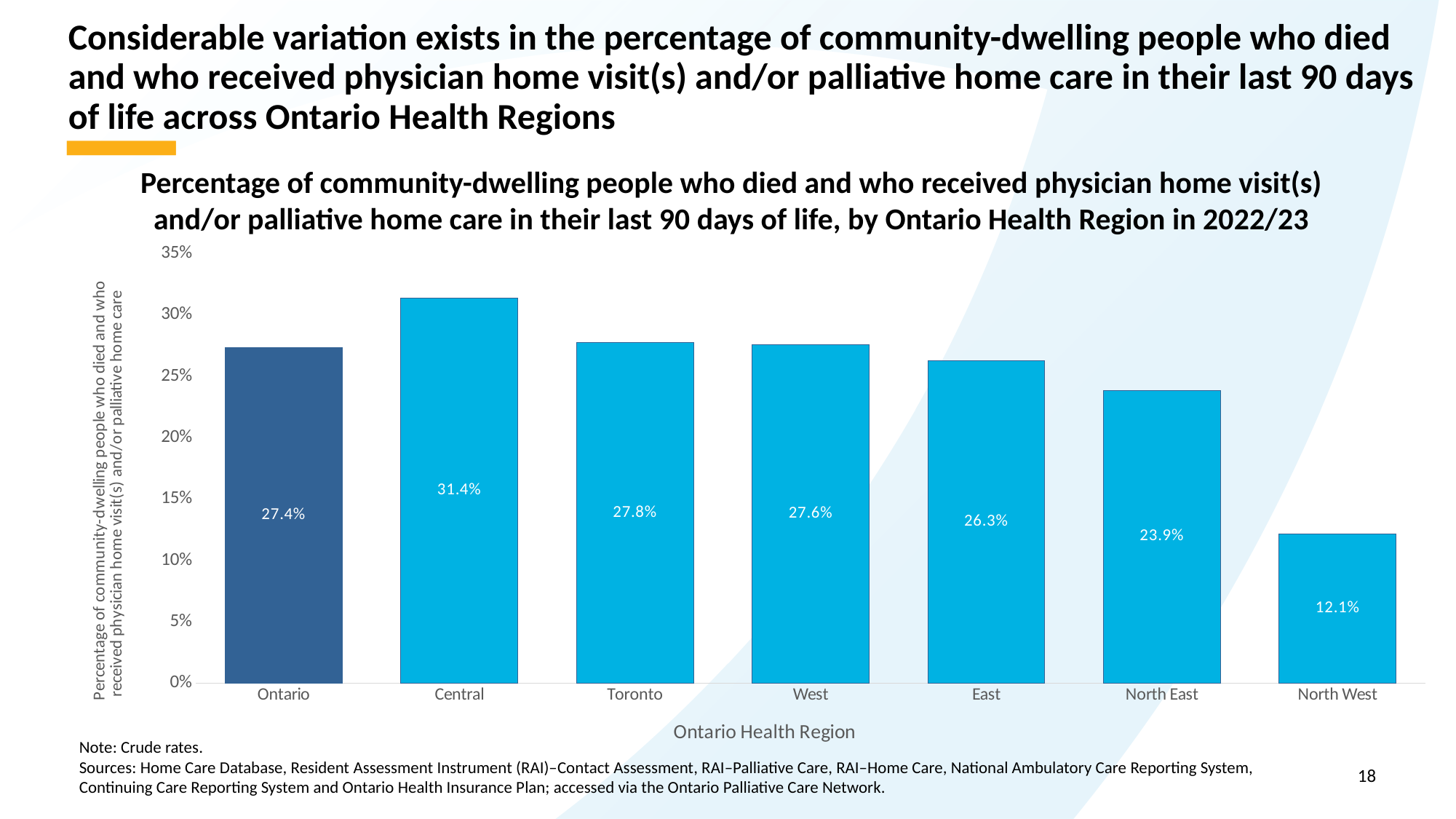
Is the value for North West greater or less than 15%? less How many bars are shown in the chart? 7 Which region has the lowest value? North West Which is larger, the value for East or the value for North East? East What is the difference between the values for Central and North West? 19.3% What is the difference between the values for East and North East? 2.4% What is the value for North West? 12.1% What kind of chart is shown on the slide? Bar chart Which region has the highest value? Central What is the value for Ontario? 27.4% What is the value for North East? 23.9% What is the value for Central? 31.4%